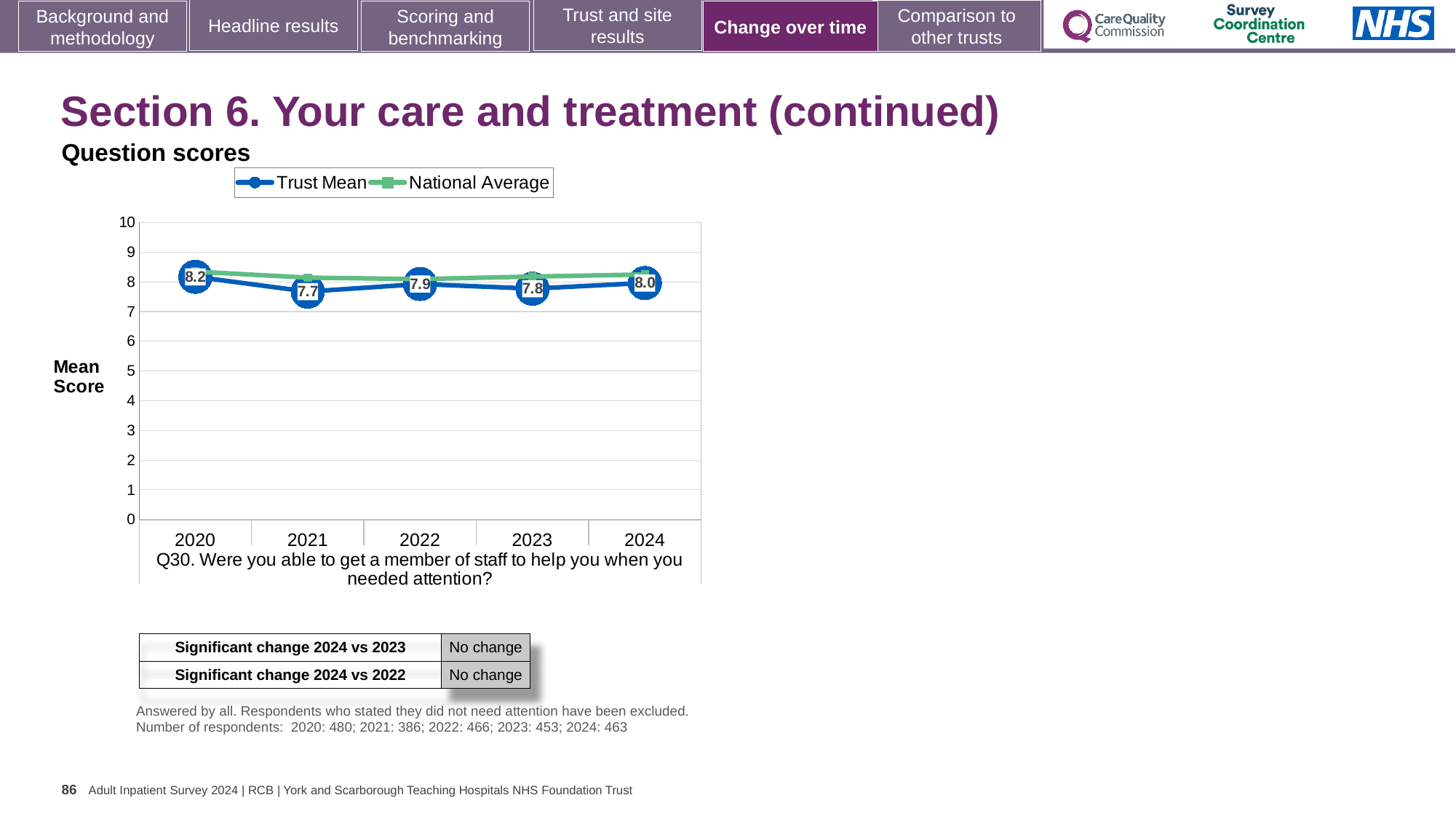
Does the Trust Mean score rise or fall from 2020 to 2021? Fall What is the Trust Mean score for 2024? 8.0 In which year is the Trust Mean score lowest? 2021 What is the difference between the Trust Mean scores for 2020 and 2021? 0.5 Which is larger, the Trust Mean score for 2022 or for 2023? 2022 What kind of chart is shown on the slide? Line chart How many series does the legend list? 2 How many years are plotted on the x axis? 5 In which year is the Trust Mean score highest? 2020 Is the National Average value for 2020 greater or less than 7? greater What is the Trust Mean score for 2020? 8.2 What is the Trust Mean score for 2021? 7.7